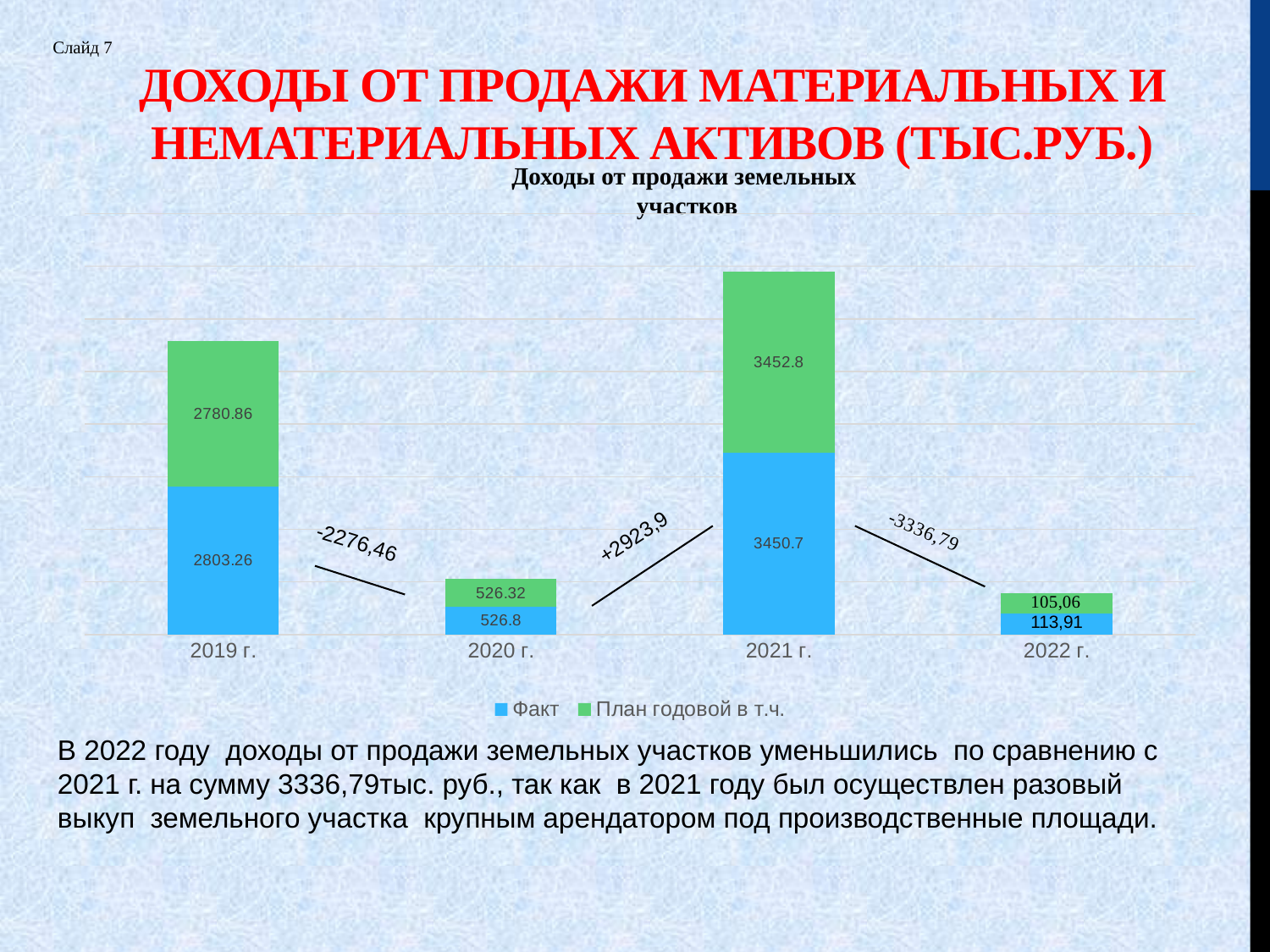
Which is larger, the Факт value for 2019 г. or for 2021 г.? 2021 г. What is the difference between the Факт values for 2021 г. and 2020 г.? 2923.9 What is the Факт value for 2021 г.? 3450.7 How many years are shown on the x axis? 4 What is the total of the stacked bar for 2020 г.? 1053.12 Which year has the lowest Факт value? 2022 г. What is the План годовой в т.ч. value for 2019 г.? 2780.86 What is the Факт value for 2022 г.? 113,91 What is the План годовой в т.ч. value for 2020 г.? 526.32 What kind of chart is shown? Stacked bar chart Which year has the highest Факт value? 2021 г. How many series does the legend list? 2